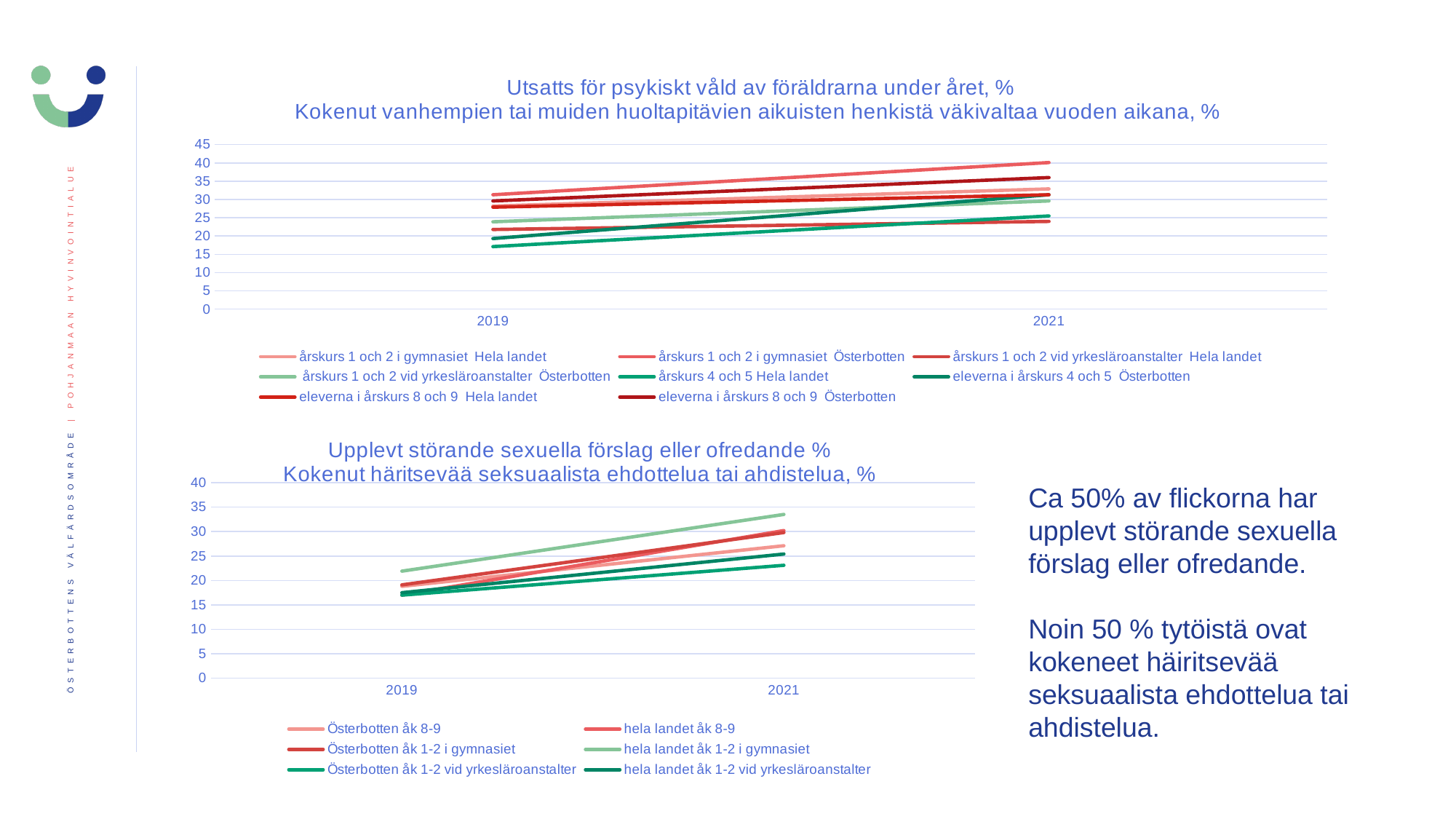
How many years are shown on the x axis of the top chart ("Utsatts för psykiskt våld av föräldrarna under året, %")? 2 What kind of chart is the top chart titled "Utsatts för psykiskt våld av föräldrarna under året, %"? Line chart In the top chart ("Utsatts för psykiskt våld av föräldrarna under året, %"), is the 2021 value for "årskurs 1 och 2 i gymnasiet Österbotten" greater or less than 35? greater How many series does the legend of the top chart ("Utsatts för psykiskt våld av föräldrarna under året, %") list? 8 In the top chart ("Utsatts för psykiskt våld av föräldrarna under året, %"), which series has the highest value in 2021? årskurs 1 och 2 i gymnasiet Österbotten In the bottom chart ("Upplevt störande sexuella förslag eller ofredande %"), which series has the highest value in 2021? hela landet åk 1-2 i gymnasiet In the top chart ("Utsatts för psykiskt våld av föräldrarna under året, %"), which series has the lowest value in 2019? årskurs 4 och 5 Hela landet How many series does the legend of the bottom chart ("Upplevt störande sexuella förslag eller ofredande %") list? 6 In the bottom chart ("Upplevt störande sexuella förslag eller ofredande %"), which is larger in 2021: "hela landet åk 1-2 i gymnasiet" or "Österbotten åk 1-2 vid yrkesläroanstalter"? hela landet åk 1-2 i gymnasiet What kind of chart is the bottom chart titled "Upplevt störande sexuella förslag eller ofredande %"? Line chart In the top chart ("Utsatts för psykiskt våld av föräldrarna under året, %"), does the line for "årskurs 1 och 2 i gymnasiet Österbotten" rise or fall from 2019 to 2021? Rise In the bottom chart ("Upplevt störande sexuella förslag eller ofredande %"), is the 2021 value for "hela landet åk 1-2 i gymnasiet" greater or less than 30? greater